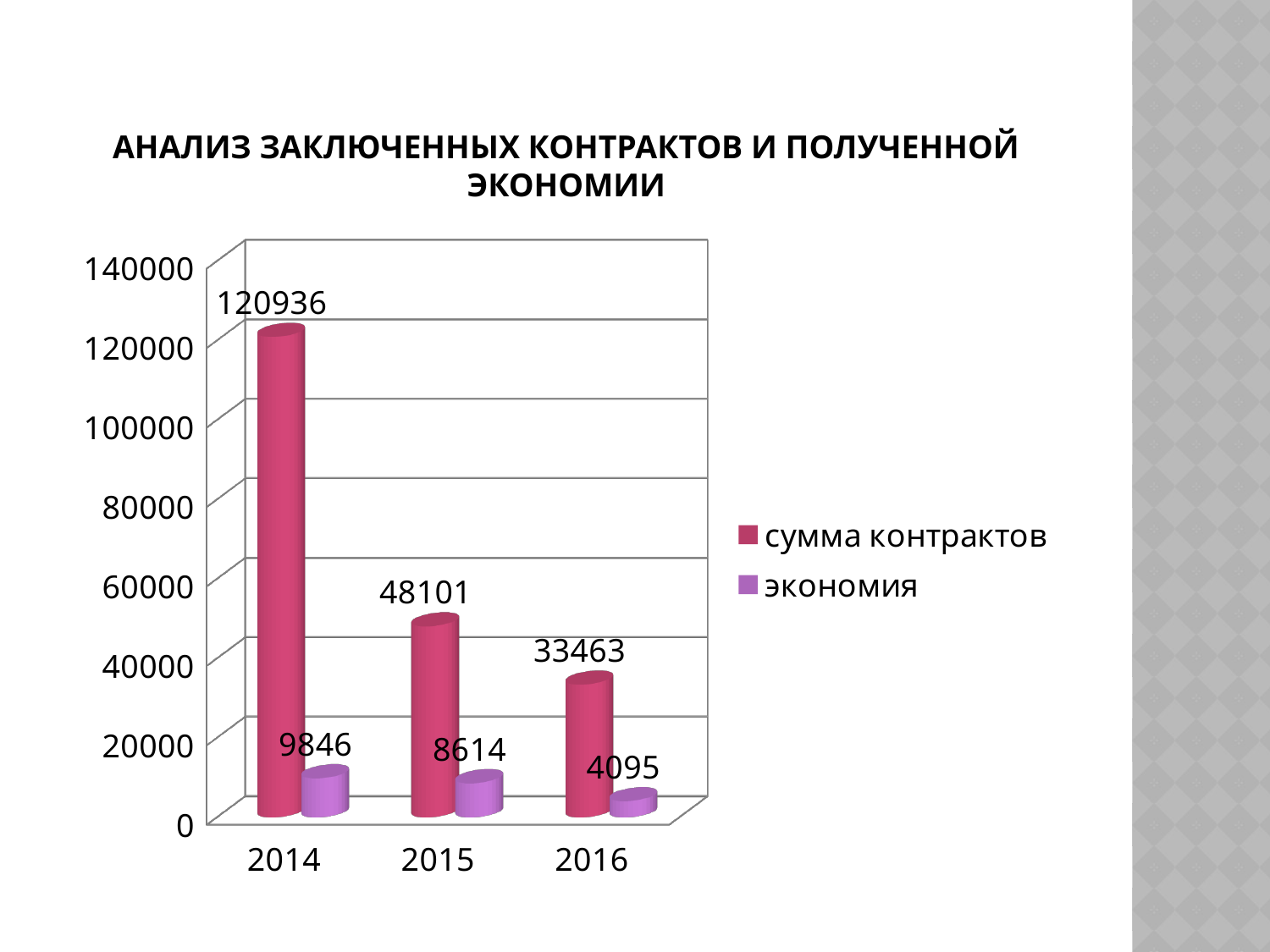
Does сумма контрактов rise or fall from 2014 to 2016? fall What is the value of экономия for 2015? 8614 Which year has the highest сумма контрактов? 2014 What is the difference between экономия in 2014 and 2016? 5751 What is the value of сумма контрактов for 2014? 120936 How many series does the legend list? 2 What is the value of сумма контрактов for 2016? 33463 What is the value of экономия for 2016? 4095 Which is larger: сумма контрактов in 2015 or in 2016? 2015 What is the difference between сумма контрактов in 2014 and 2015? 72835 Which year has the lowest экономия? 2016 How many years are shown on the x axis? 3